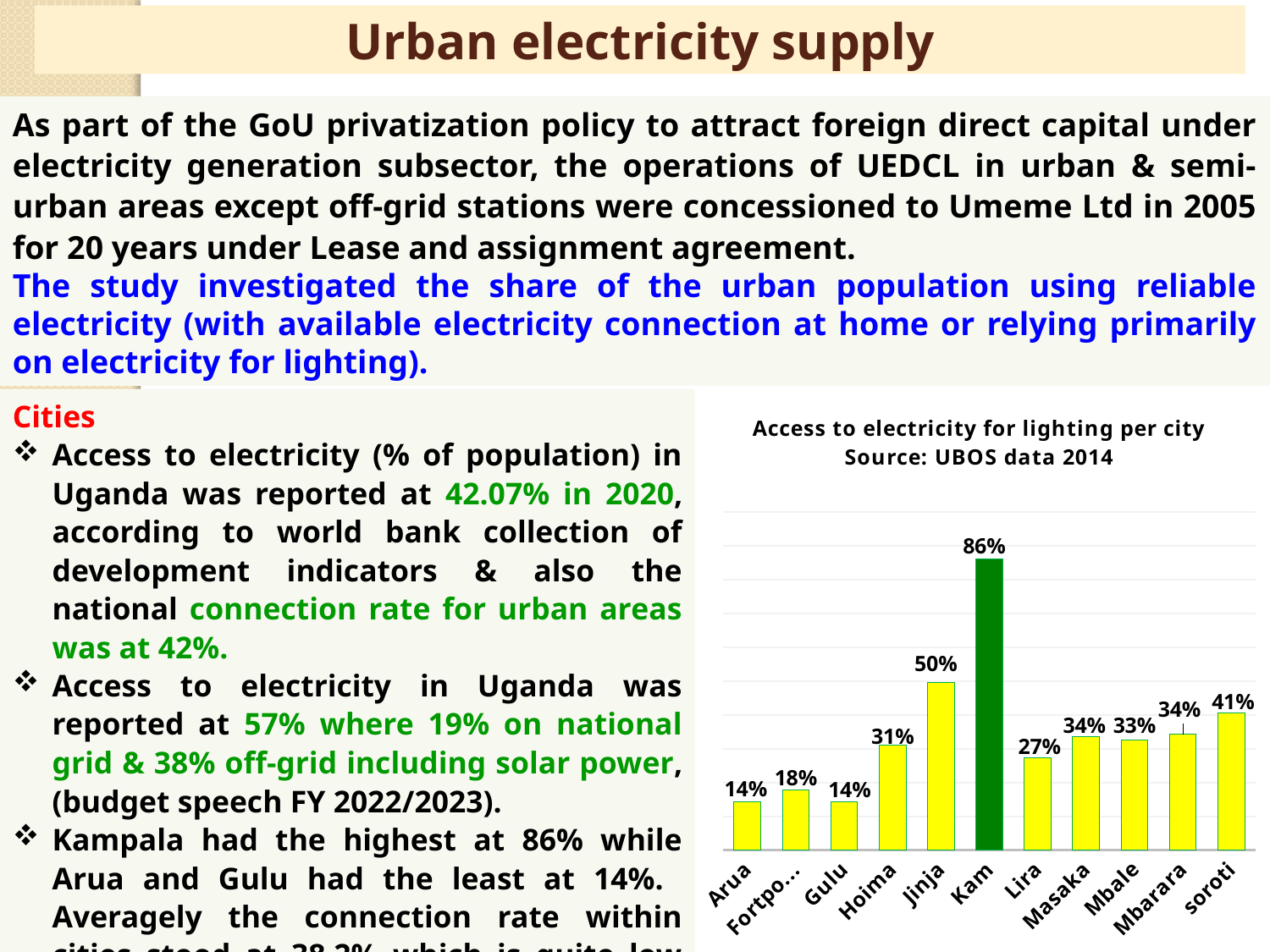
What is the title of the chart? Access to electricity for lighting per city What is the value for Jinja in the chart? 50% What is the value for Kam in the chart? 86% What is the value for Hoima in the chart? 31% Which cities have the lowest value in the chart? Arua and Gulu What is the difference between the values for Kam and Jinja? 36% Which bar in the chart is coloured green rather than yellow? Kam Which city has the highest value in the chart? Kam How many cities are shown in the chart? 11 Which has a larger value, Lira or Mbale? Mbale What type of chart is shown on the slide? Bar chart What is the value for soroti in the chart? 41%